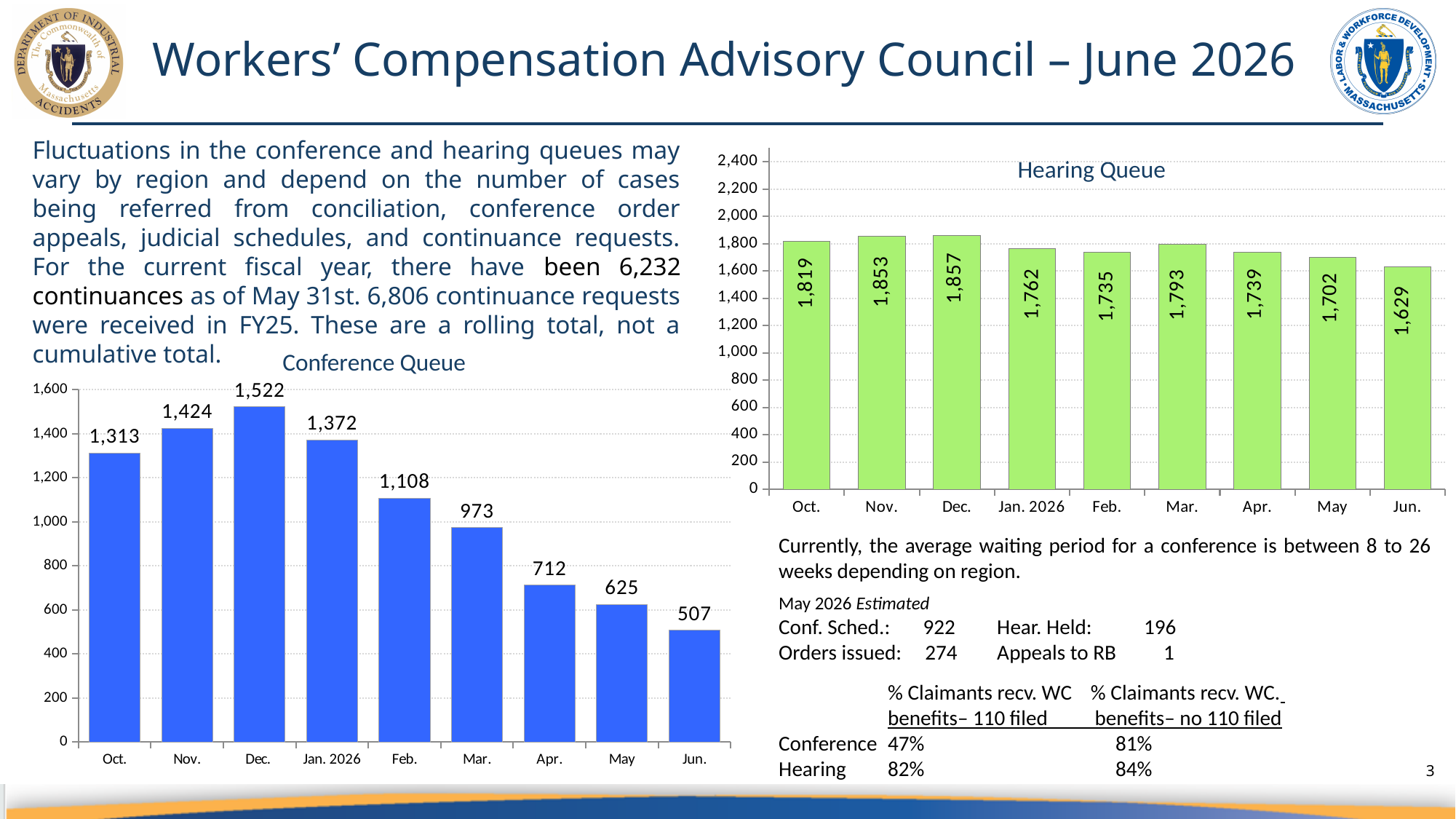
In the Conference Queue chart, what is the value for Dec.? 1,522 In the Hearing Queue chart, what is the difference between the Mar. and Feb. values? 58 What colour are the bars in the Hearing Queue chart? green In the Conference Queue chart, is the value for Mar. greater or less than 1,000? less In the Conference Queue chart, which month has the lowest value? Jun. In the Conference Queue chart, do the values rise or fall from Dec. to Jun.? fall In the Hearing Queue chart, which is larger, the value for Apr. or the value for May? Apr. How many months are shown in the Conference Queue chart? 9 In the Hearing Queue chart, what is the value for Jun.? 1,629 In the Conference Queue chart, what is the difference between the Nov. and Oct. values? 111 In the Hearing Queue chart, which month has the highest value? Dec. What kind of chart is the Hearing Queue chart? bar chart